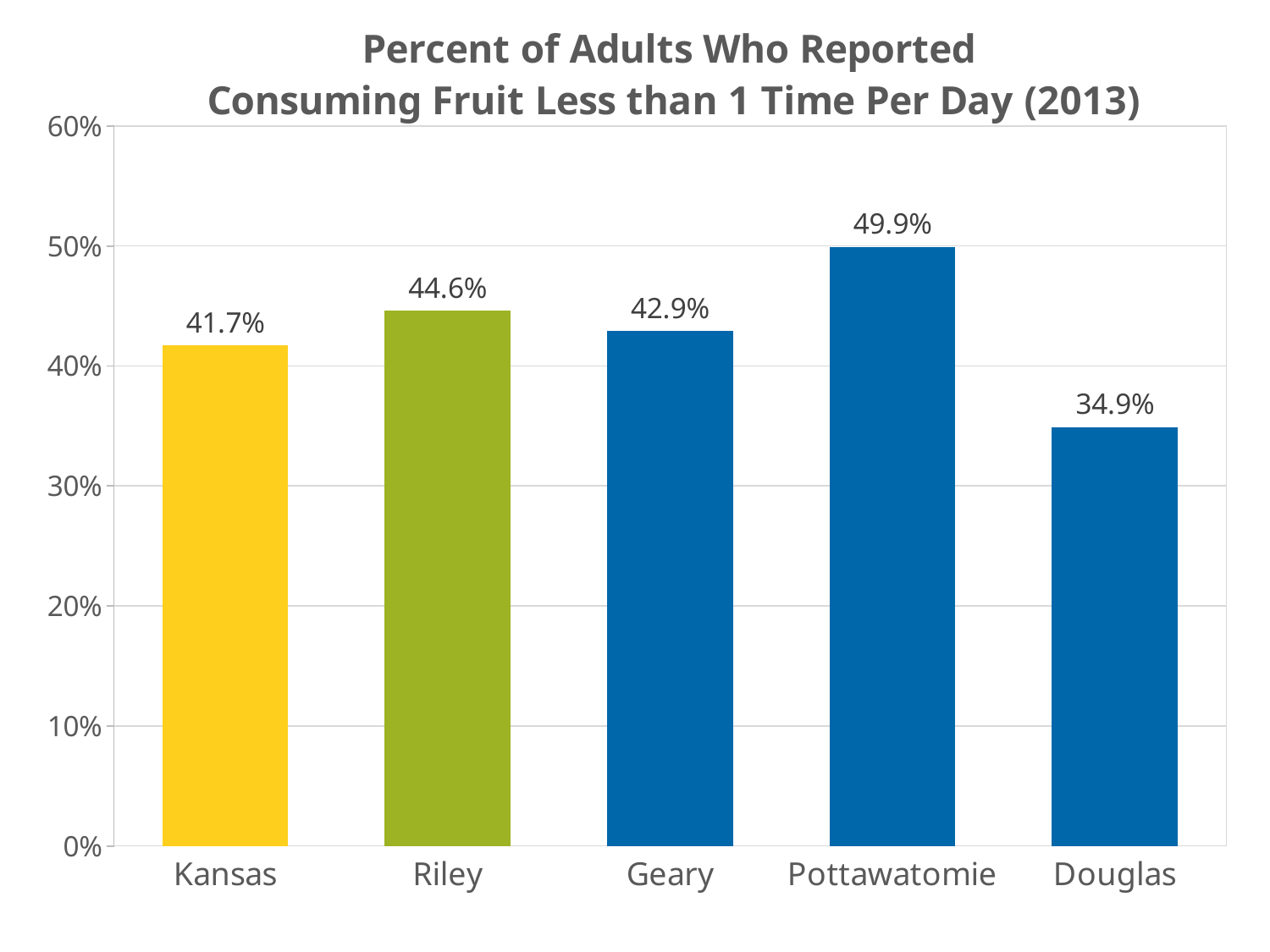
What is the value for Douglas? 34.9% Which category has the highest value? Pottawatomie What kind of chart is this? bar chart Is the value for Douglas greater or less than 40%? less What is the value for Pottawatomie? 49.9% What is the title of the chart? Percent of Adults Who Reported Consuming Fruit Less than 1 Time Per Day (2013) What is the difference between the values for Pottawatomie and Douglas? 15.0% Which category has the lowest value? Douglas What is the difference between the values for Riley and Kansas? 2.9% How many categories are shown on the x axis? 5 Which is larger, the value for Riley or the value for Geary? Riley What is the value for Kansas? 41.7%